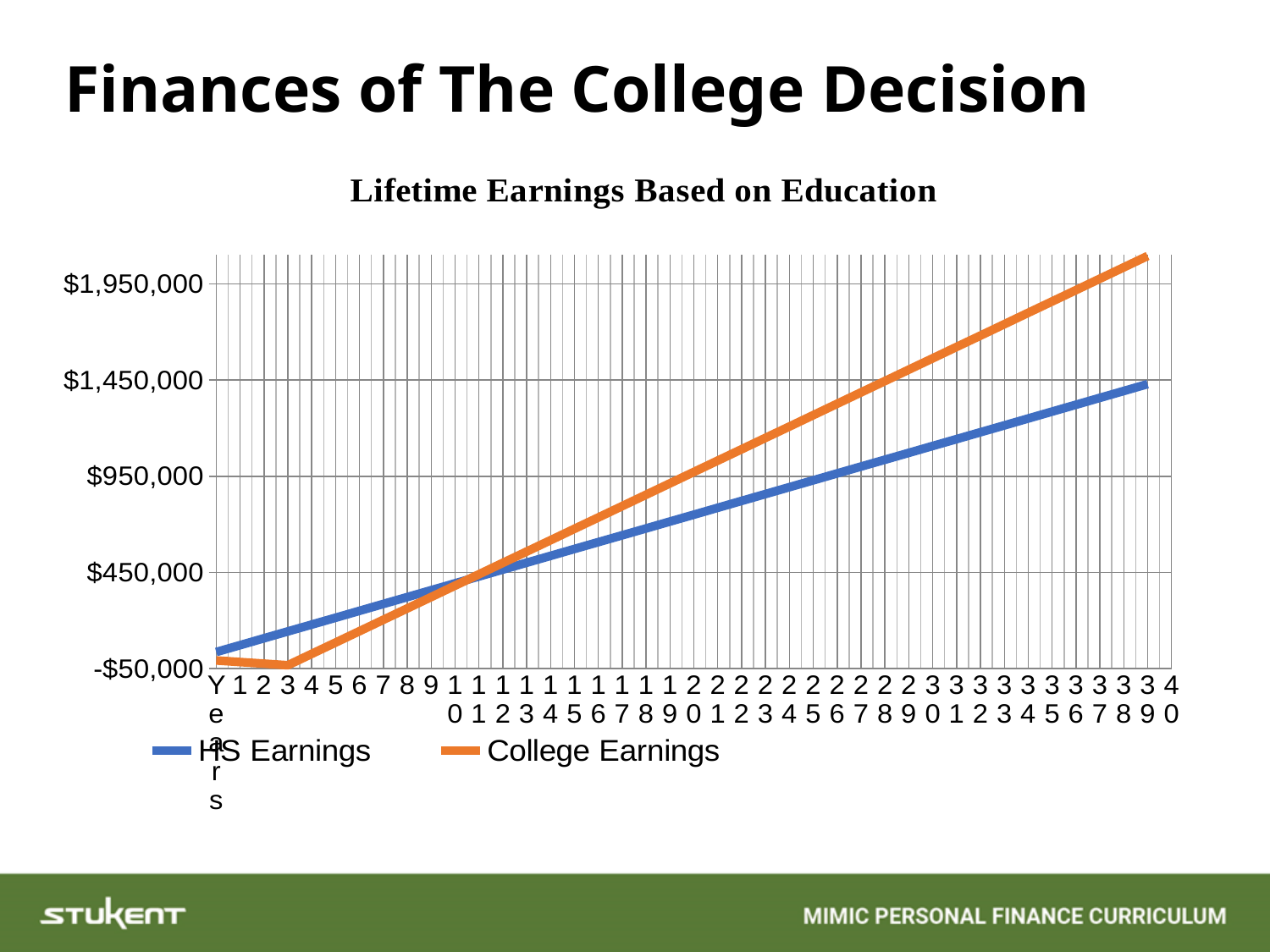
What is the title of the chart? Lifetime Earnings Based on Education How many series does the legend of the chart list? 2 Over the full range of years, does the College Earnings line overall rise or fall? Rise What kind of chart is shown on the slide? Line chart Is the value for HS Earnings at year 20 greater or less than $950,000? less At year 3, which series has the higher value, HS Earnings or College Earnings? HS Earnings Which series is drawn in orange in the chart? College Earnings Does the HS Earnings line rise or fall as the years increase? Rise Is the value for College Earnings at year 3 greater or less than $450,000? less